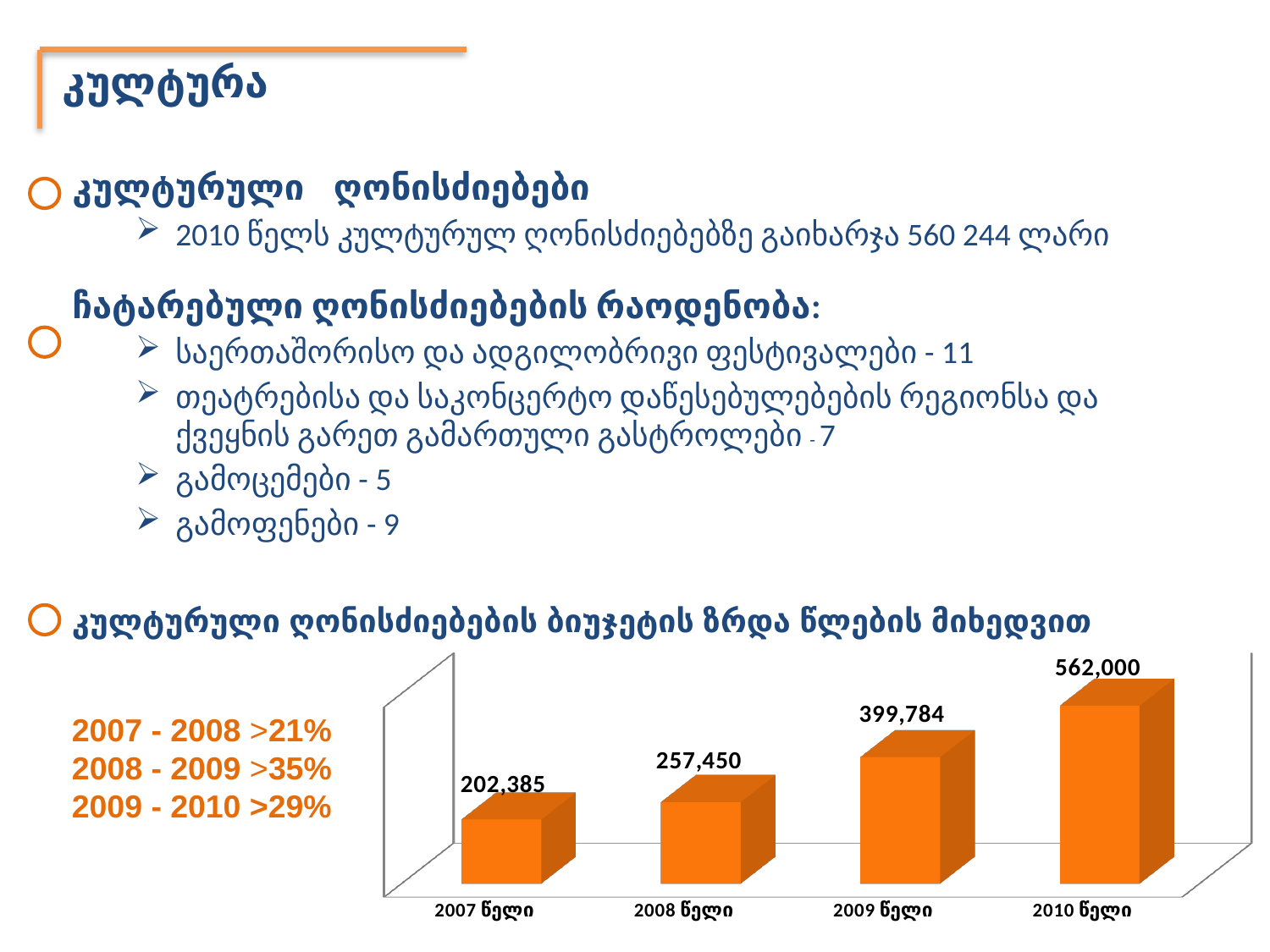
What is the value for 2007 წელი? 202,385 What is the value for 2008 წელი? 257,450 What kind of chart is shown on the slide? bar chart Which year has the lowest value? 2007 წელი What is the value for 2010 წელი? 562,000 What is the value for 2009 წელი? 399,784 Do the values rise or fall from 2007 წელი to 2010 წელი? rise Which is larger, the value for 2008 წელი or the value for 2009 წელი? 2009 წელი What is the difference between the values for 2010 წელი and 2007 წელი? 359,615 Which year has the highest value? 2010 წელი What is the difference between the values for 2009 წელი and 2008 წელი? 142,334 How many bars are shown in the chart? 4